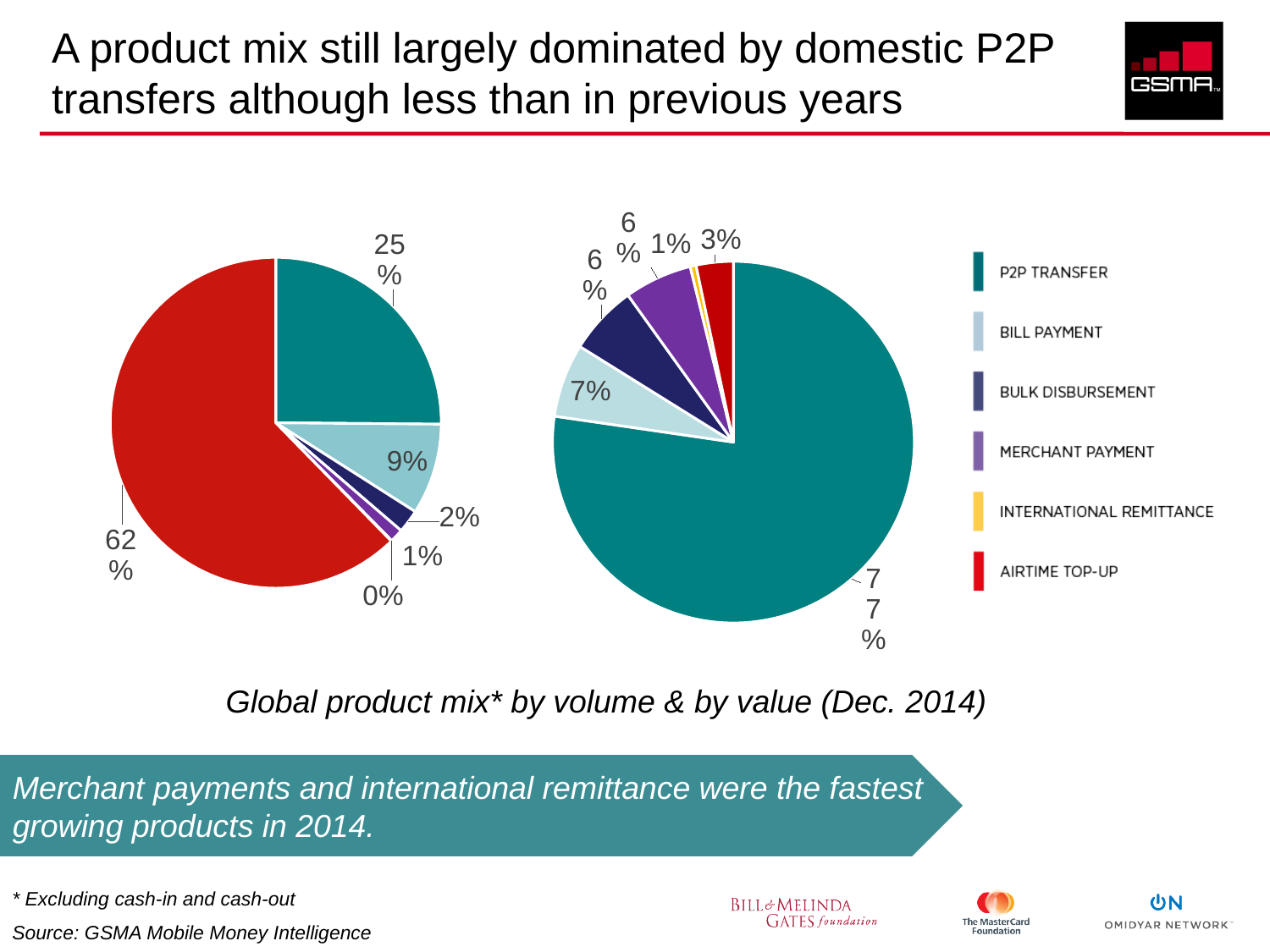
In the right pie chart, what share is labelled for the Bill Payment slice? 7% In the left pie chart, which category has the smallest labelled share? International Remittance In the left pie chart, what share is labelled for the Airtime Top-up slice? 62% How many categories does the legend list? 6 What type of chart is used on this slide? Pie chart In the left pie chart, which category has the largest slice? Airtime Top-up In the right pie chart, what share is labelled for the Airtime Top-up slice? 3% In the left pie chart, what share is labelled for the P2P Transfer slice? 25% In the right pie chart, what share is labelled for the P2P Transfer slice? 77% In the left pie chart, what is the difference between the Airtime Top-up share and the P2P Transfer share? 37% In the right pie chart, which category has the largest slice? P2P Transfer In the left pie chart, what share is labelled for the Bill Payment slice? 9%